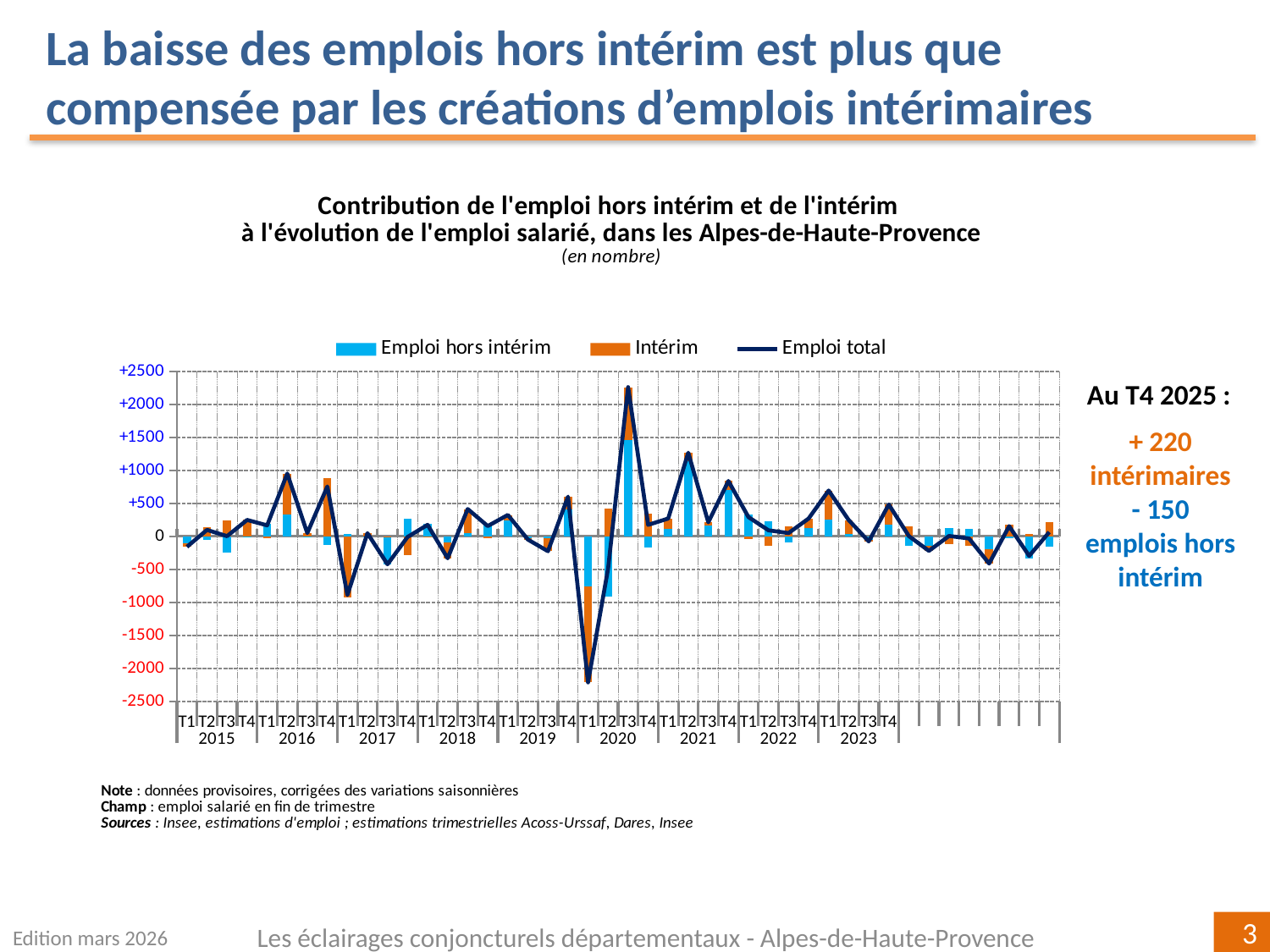
Is the Emploi hors intérim value at T1 2020 greater or less than -500? less Is the Emploi total value at T3 2020 greater or less than +2000? greater How many series does the legend list? 3 In which quarter does the Emploi total line reach its lowest value? T1 2020 In which quarter does the Emploi total line reach its highest value? T3 2020 According to the annotation, what is the value for emplois hors intérim at T4 2025? - 150 Which series is drawn as a line rather than bars? Emploi total Which is larger, the Emploi total value at T3 2020 or at T1 2021? T3 2020 Is the Emploi total value at T1 2017 greater or less than -500? less What kind of chart is shown on the slide? A combined bar and line chart According to the annotation, what is the value for intérimaires at T4 2025? + 220